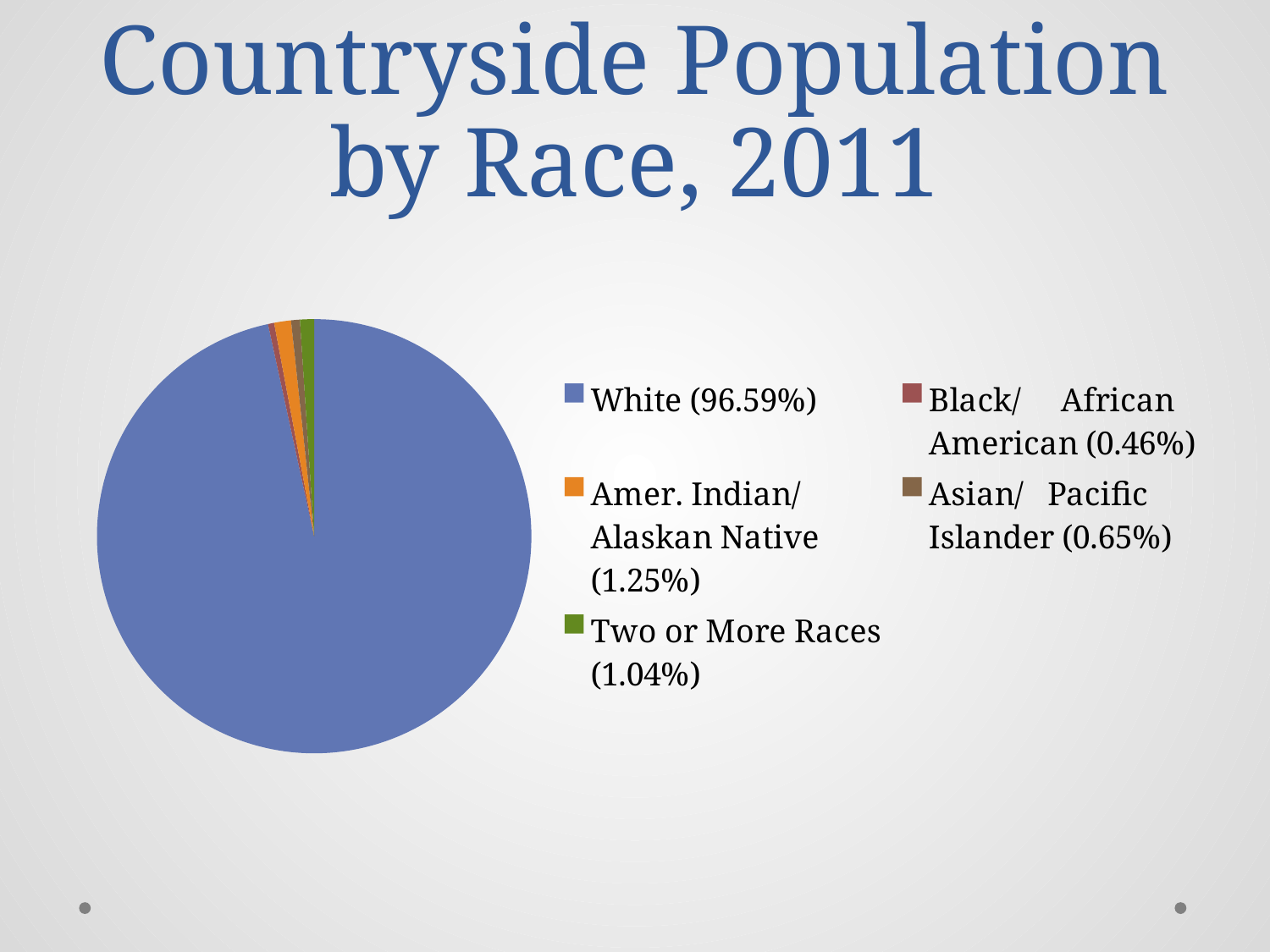
What percentage of the countryside population is Asian/Pacific Islander? 0.65% What percentage of the countryside population is Amer. Indian/Alaskan Native? 1.25% Which race category has the smallest share of the pie? Black/African American Which race category has the largest share of the pie? White What is the title of the chart? Countryside Population by Race, 2011 What type of chart is shown on the slide? Pie chart Which is larger: the share for Amer. Indian/Alaskan Native or the share for Two or More Races? Amer. Indian/Alaskan Native What percentage of the countryside population is White? 96.59% What colour is the slice representing Two or More Races? Green How many race categories does the pie chart show? 5 What is the difference in percentage points between the Amer. Indian/Alaskan Native share and the Two or More Races share? 0.21% What percentage of the countryside population is Black/African American? 0.46%